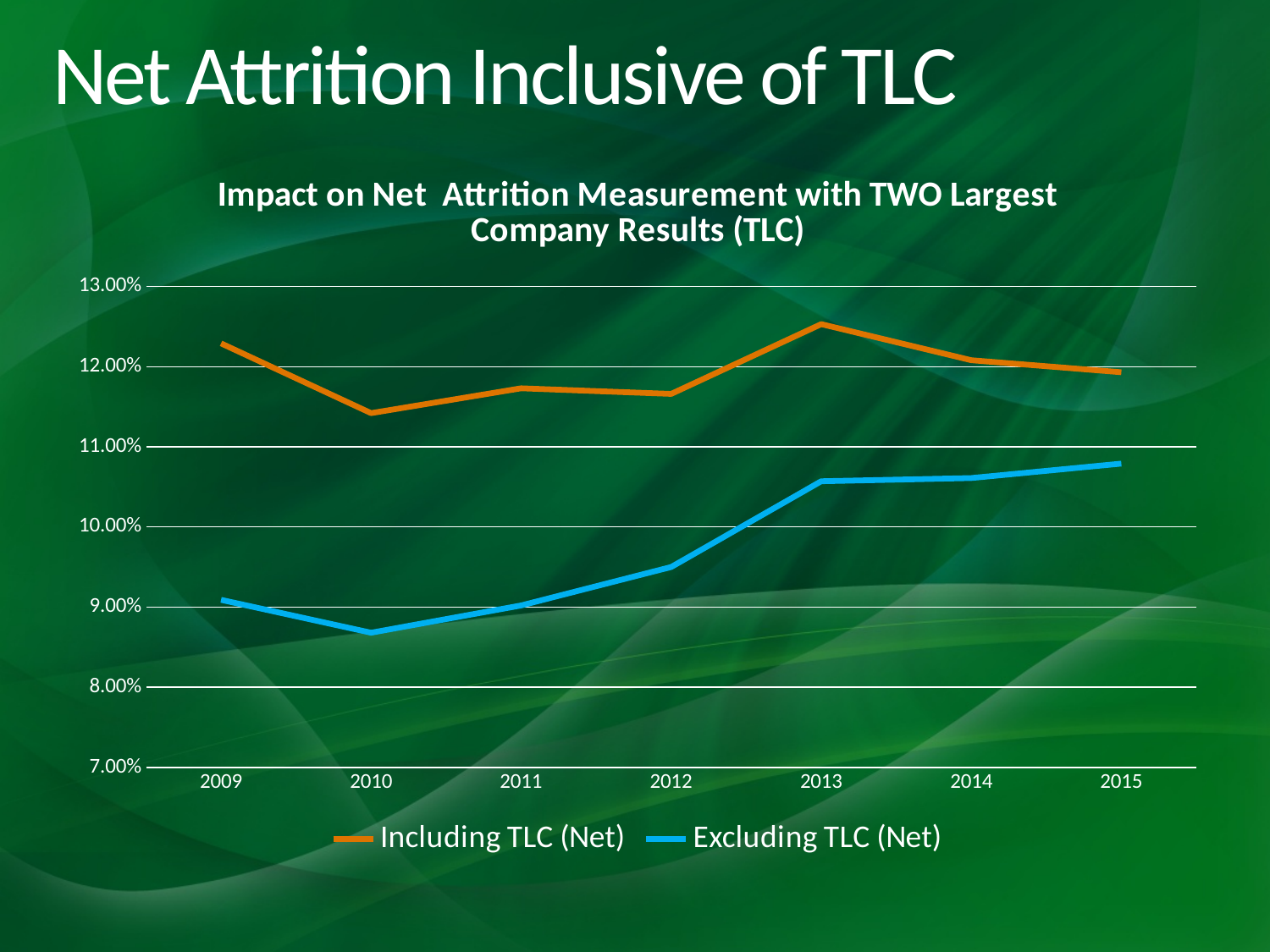
What colour is the Excluding TLC (Net) line? Blue In which year is the Including TLC (Net) line at its highest? 2013 How many series does the legend list? 2 Is the value for Excluding TLC (Net) in 2010 greater or less than 9.00%? less Does the Excluding TLC (Net) line rise or fall from 2011 to 2015? Rise How many years are shown on the x axis? 7 In which year is the Excluding TLC (Net) line at its lowest? 2010 Is the value for Excluding TLC (Net) in 2015 greater or less than 11.00%? less In which year is the Including TLC (Net) line at its lowest? 2010 Which series has the higher value in 2012, Including TLC (Net) or Excluding TLC (Net)? Including TLC (Net) What kind of chart is shown on the slide? Line chart Is the value for Including TLC (Net) in 2013 greater or less than 12.00%? greater